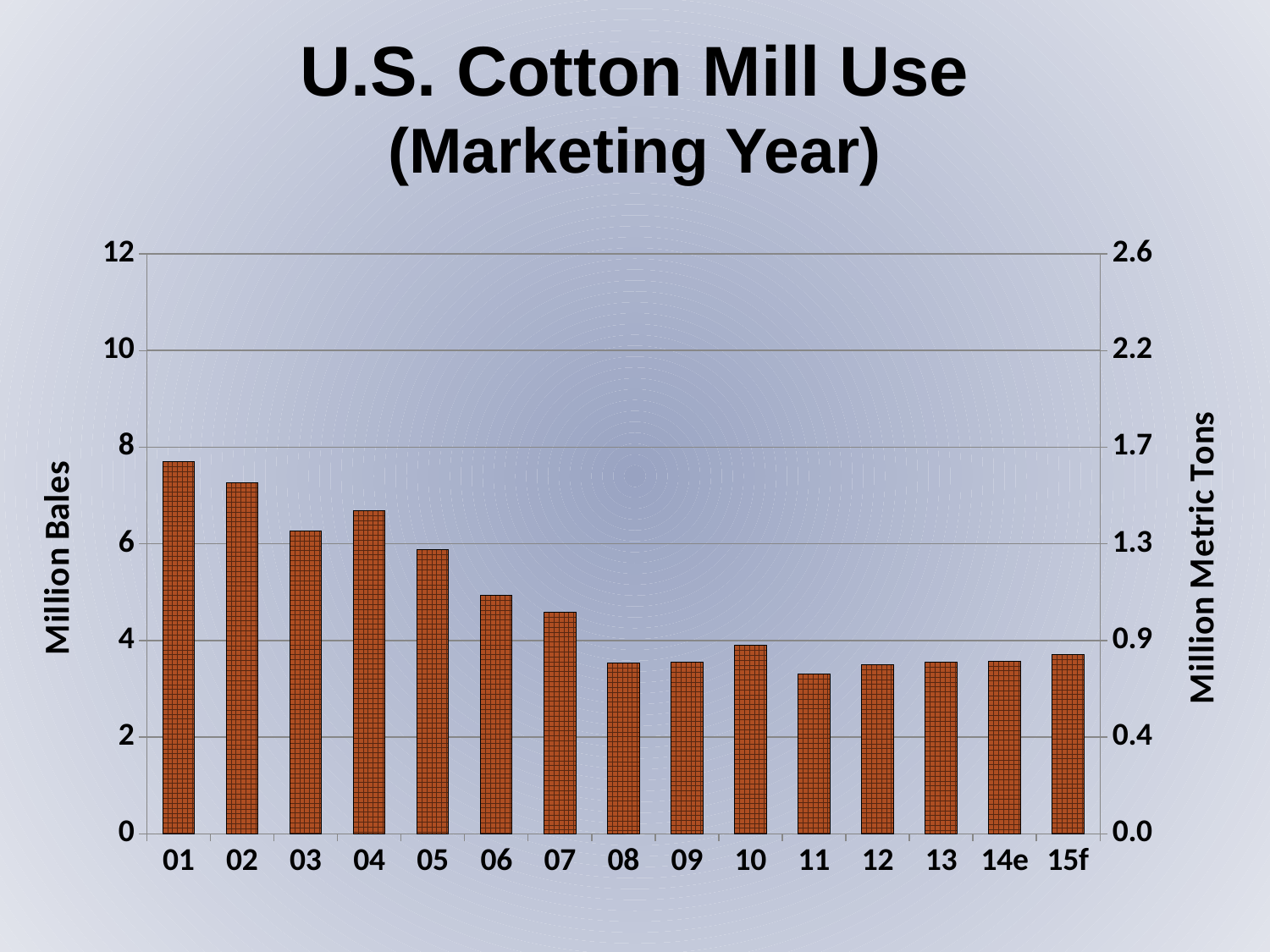
Is the value for 01 greater or less than 6 million bales? greater Which marketing year has the lowest cotton mill use? 11 Is the value for 15f greater or less than 4 million bales? less Which has the larger cotton mill use, 10 or 11? 10 What is the label on the left vertical axis? Million Bales Overall, do the values rise or fall from 01 to 15f? fall Which marketing year has the highest cotton mill use? 01 What kind of chart is shown on the slide? bar chart How many marketing years are plotted on the chart? 15 Is the value for 06 greater or less than 4 million bales? greater Which has the larger cotton mill use, 03 or 04? 04